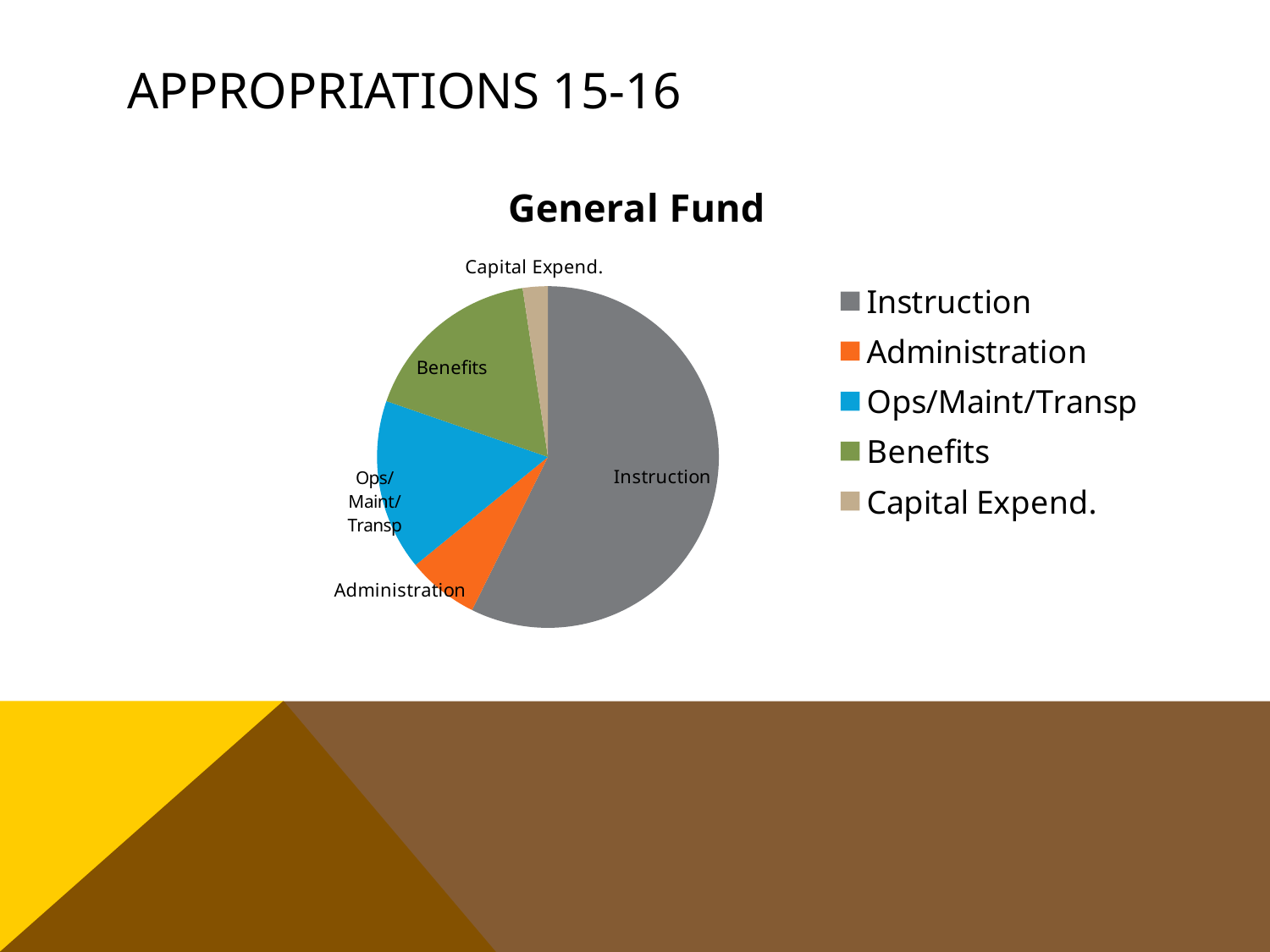
Which slice is larger, Ops/Maint/Transp or Administration? Ops/Maint/Transp What colour is the Instruction slice? Gray What is the title of the chart? General Fund Which slice is larger, Instruction or Benefits? Instruction Which category has the largest slice of the pie? Instruction Which slice is larger, Administration or Capital Expend.? Administration How many entries does the legend list? 5 What kind of chart is shown on the slide? Pie chart Which category has the smallest slice of the pie? Capital Expend. How many slices does the pie chart have? 5